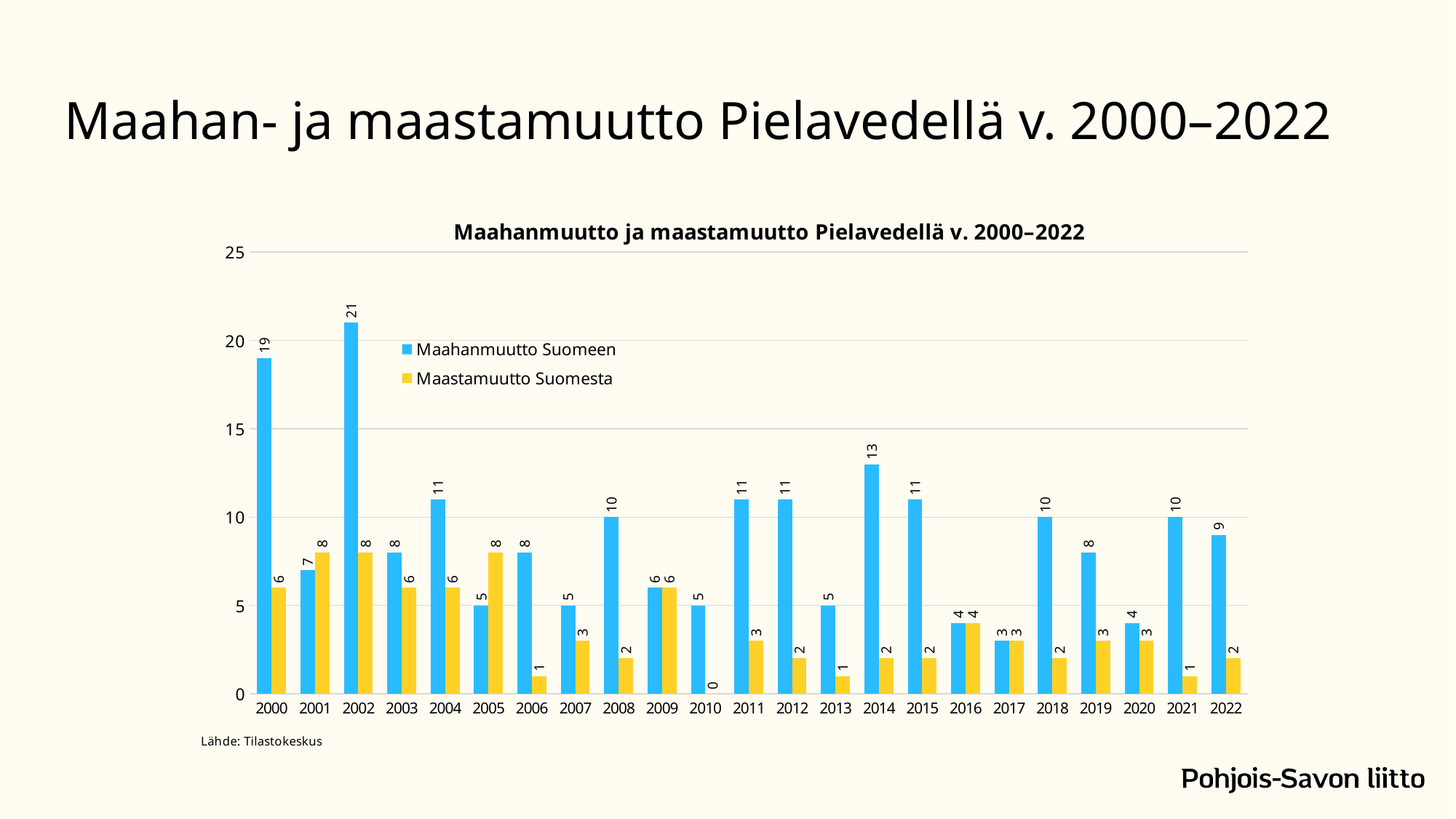
Which year has the highest value for Maahanmuutto Suomeen? 2002 Which year has the lowest value for Maahanmuutto Suomeen? 2017 Which year has the lowest value for Maastamuutto Suomesta? 2010 What colour represents Maastamuutto Suomesta in the chart? Yellow What is the value of Maahanmuutto Suomeen in 2014? 13 How many series does the legend list? 2 What kind of chart is shown on the slide? Bar chart What is the difference between Maahanmuutto Suomeen and Maastamuutto Suomesta in 2000? 13 Which is larger in 2005: Maahanmuutto Suomeen or Maastamuutto Suomesta? Maastamuutto Suomesta What is the value of Maastamuutto Suomesta in 2010? 0 What is the value of Maahanmuutto Suomeen in 2002? 21 How many years are shown on the x axis? 23